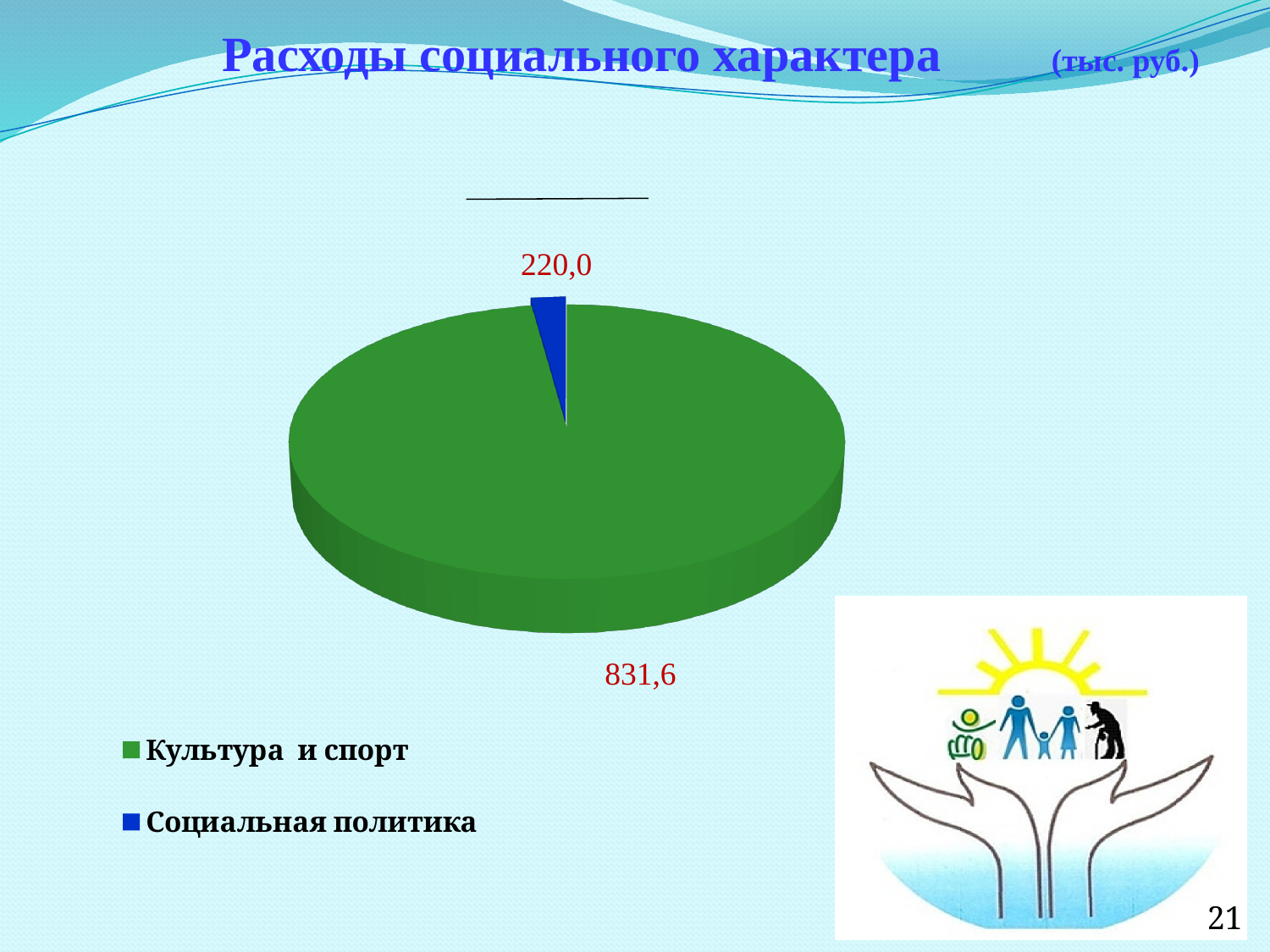
What is the title of the chart on the slide? Расходы социального характера (тыс. руб.) What is the value shown for Социальная политика? 220,0 What colour is the slice for Социальная политика? Blue What is the value shown for Культура и спорт? 831,6 Which is larger, the value for Культура и спорт or the value for Социальная политика? Культура и спорт How many entries does the legend list? 2 What kind of chart is shown on the slide? Pie chart What is the difference between the values for Культура и спорт and Социальная политика? 611,6 What is the total of the two values shown on the pie chart? 1051,6 Which category has the smallest slice of the pie? Социальная политика Which category has the largest slice of the pie? Культура и спорт How many categories does the pie chart show? 2